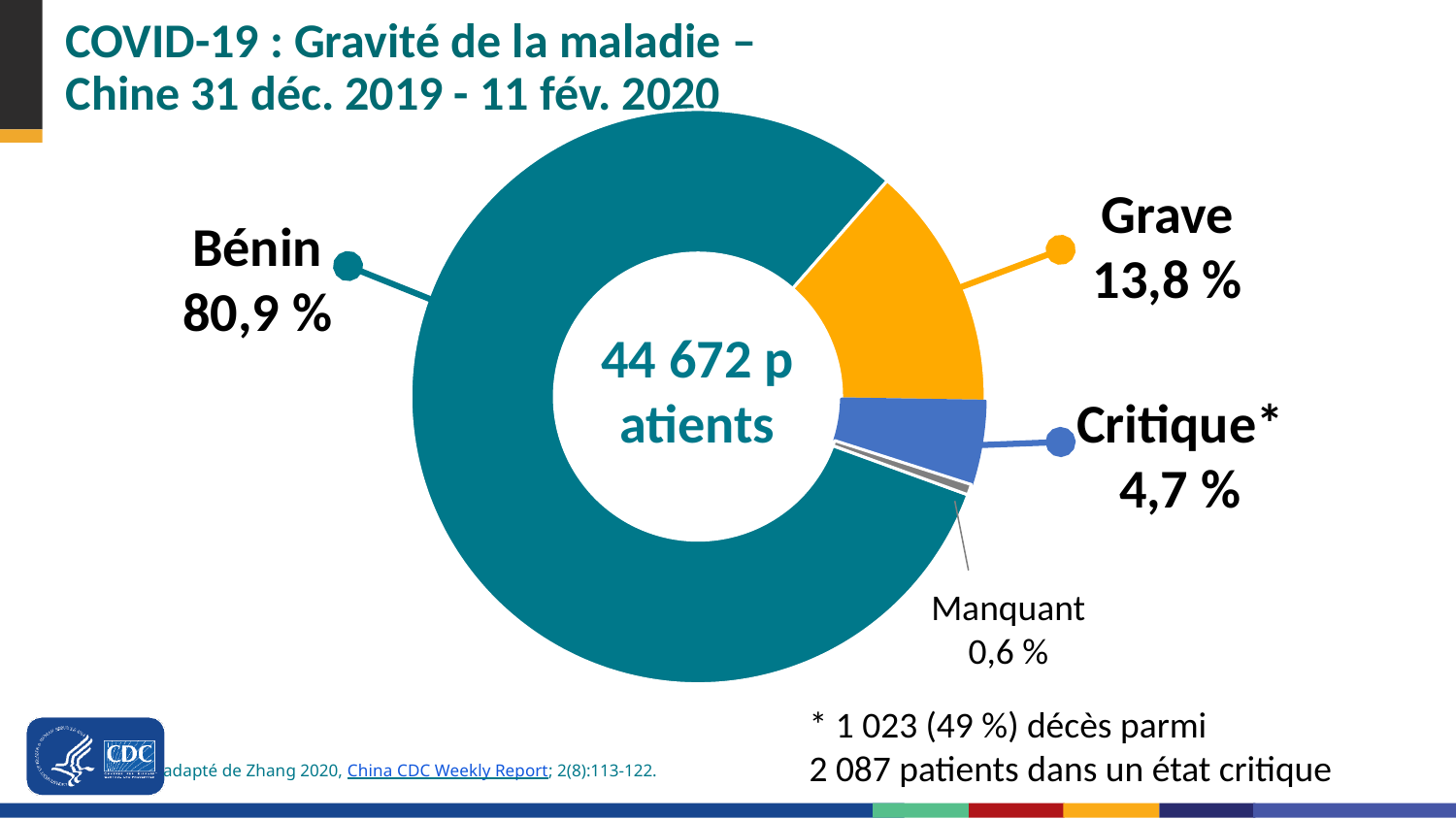
Which category has the smallest share of the chart? Manquant What percentage of cases are labelled Manquant (missing)? 0,6 % What colour is the Grave slice of the chart? Orange Which is larger, the share for Grave or the share for Critique? Grave What percentage of patients had a severe (Grave) form of the disease? 13,8 % How many categories are shown in the chart? 4 What total number of patients is shown in the centre of the chart? 44 672 patients What kind of chart is shown on the slide? Doughnut (pie) chart What percentage of patients were in a critical (Critique) state? 4,7 % What is the difference in percentage points between the Grave and Critique categories? 9,1 Which category has the largest share of the chart? Bénin What percentage of patients had a benign (Bénin) form of the disease? 80,9 %